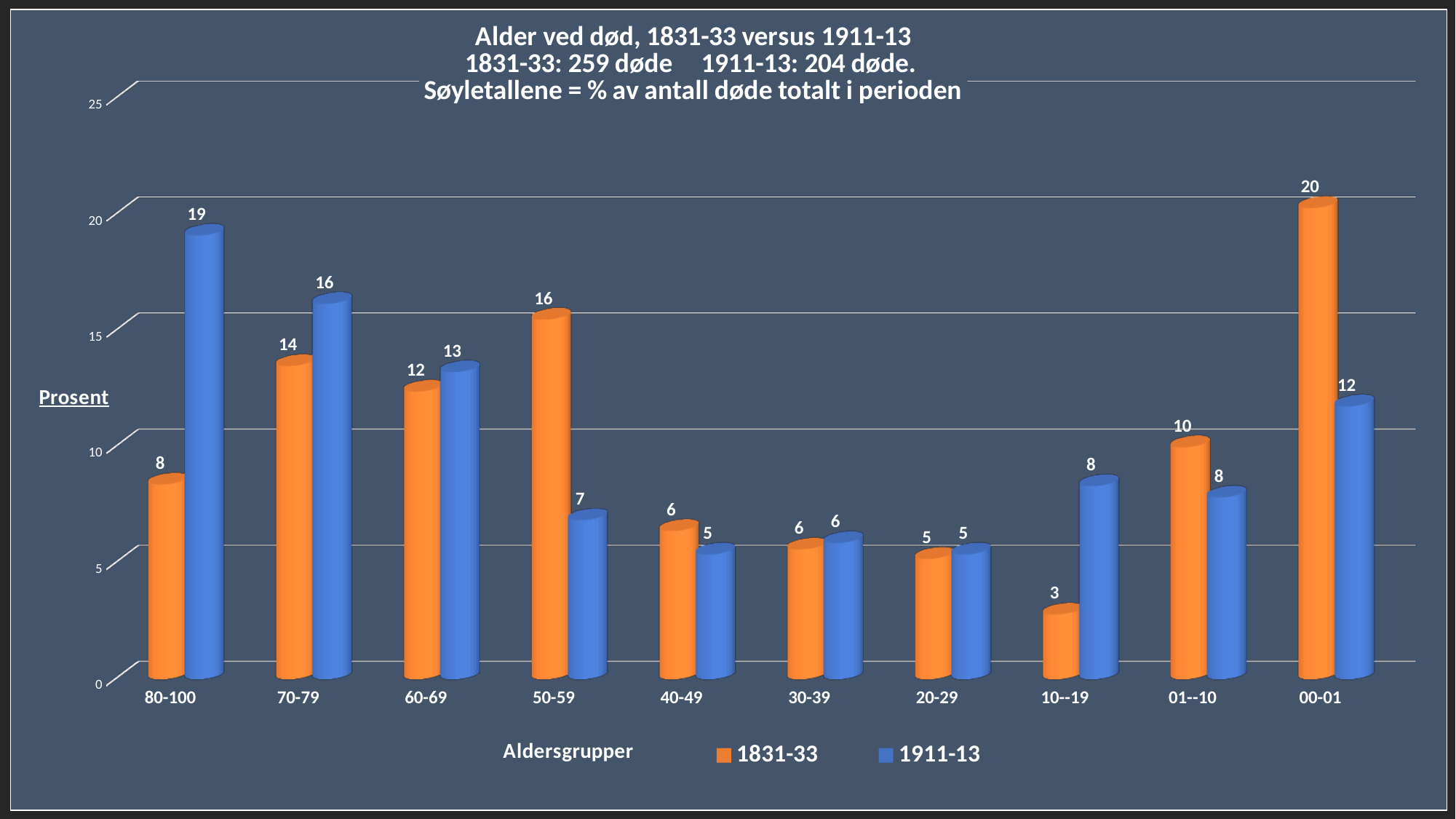
How many series does the legend list? 2 What is the label of the y axis? Prosent What is the value for the 10--19 age group in the 1831-33 series? 3 What is the difference between the 1831-33 and 1911-13 values for the 50-59 age group? 9 Which age group has the lowest value in the 1911-13 series? 40-49 and 20-29 Which series has the larger value for the 10--19 age group, 1831-33 or 1911-13? 1911-13 What kind of chart is shown on the slide? Bar chart What is the value for the 50-59 age group in the 1831-33 series? 16 Which colour represents the 1911-13 series? Blue How many age groups are shown on the x axis? 10 Which age group has the highest value in the 1831-33 series? 00-01 What is the value for the 80-100 age group in the 1911-13 series? 19